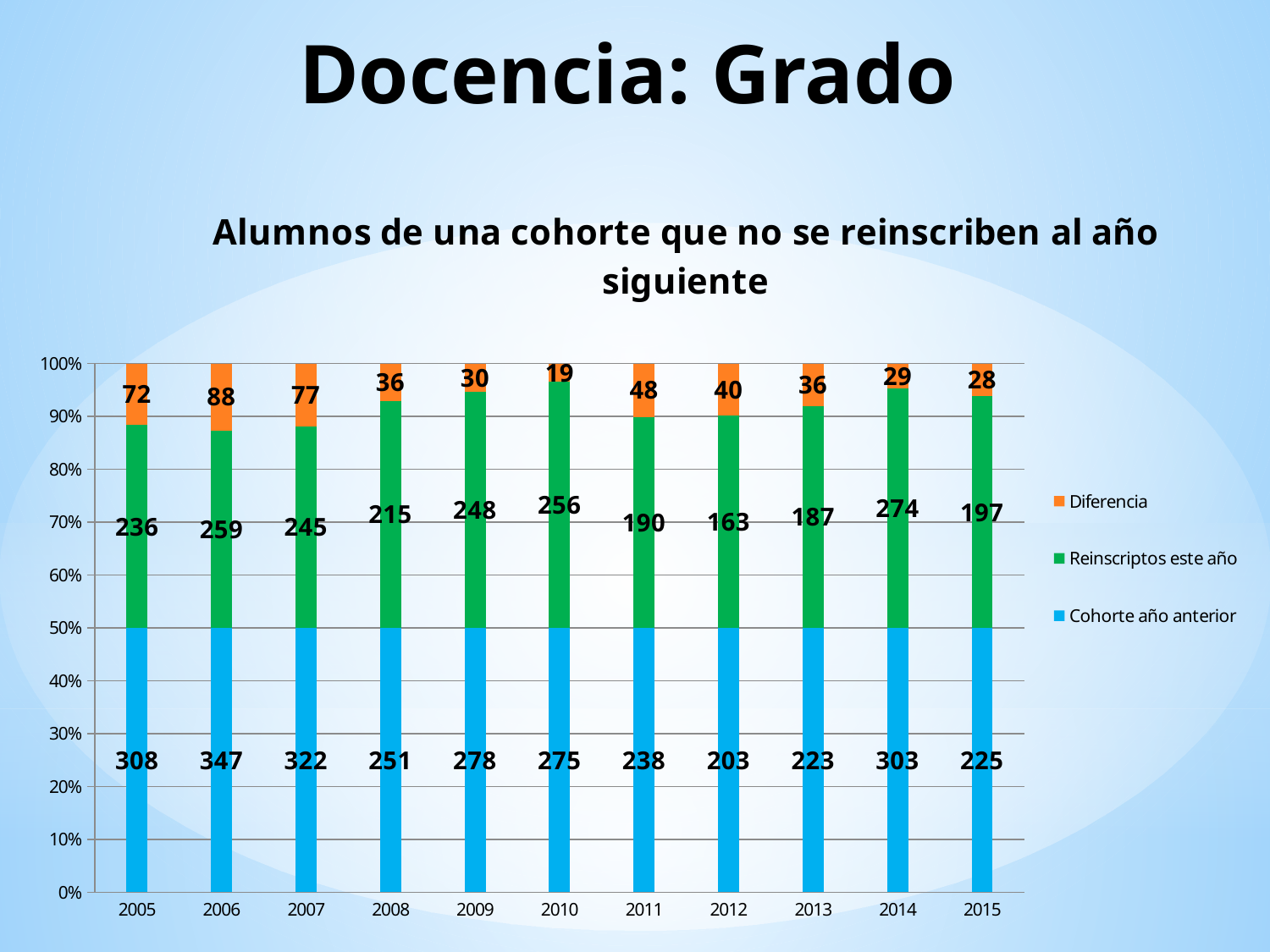
Which year has the lowest value for Cohorte año anterior? 2012 How many series does the legend list? 3 Which is larger, the Diferencia value for 2011 or for 2012? 2011 What kind of chart is shown on the slide? Stacked bar chart How many years are shown on the x axis? 11 What is the title of the chart? Alumnos de una cohorte que no se reinscriben al año siguiente Which year has the highest value for Diferencia? 2006 Which year has the lowest value for Reinscriptos este año? 2012 What is the value of Cohorte año anterior for 2006? 347 What is the value of Diferencia for 2010? 19 What is the difference between the Cohorte año anterior values for 2005 and 2015? 83 What is the value of Reinscriptos este año for 2014? 274